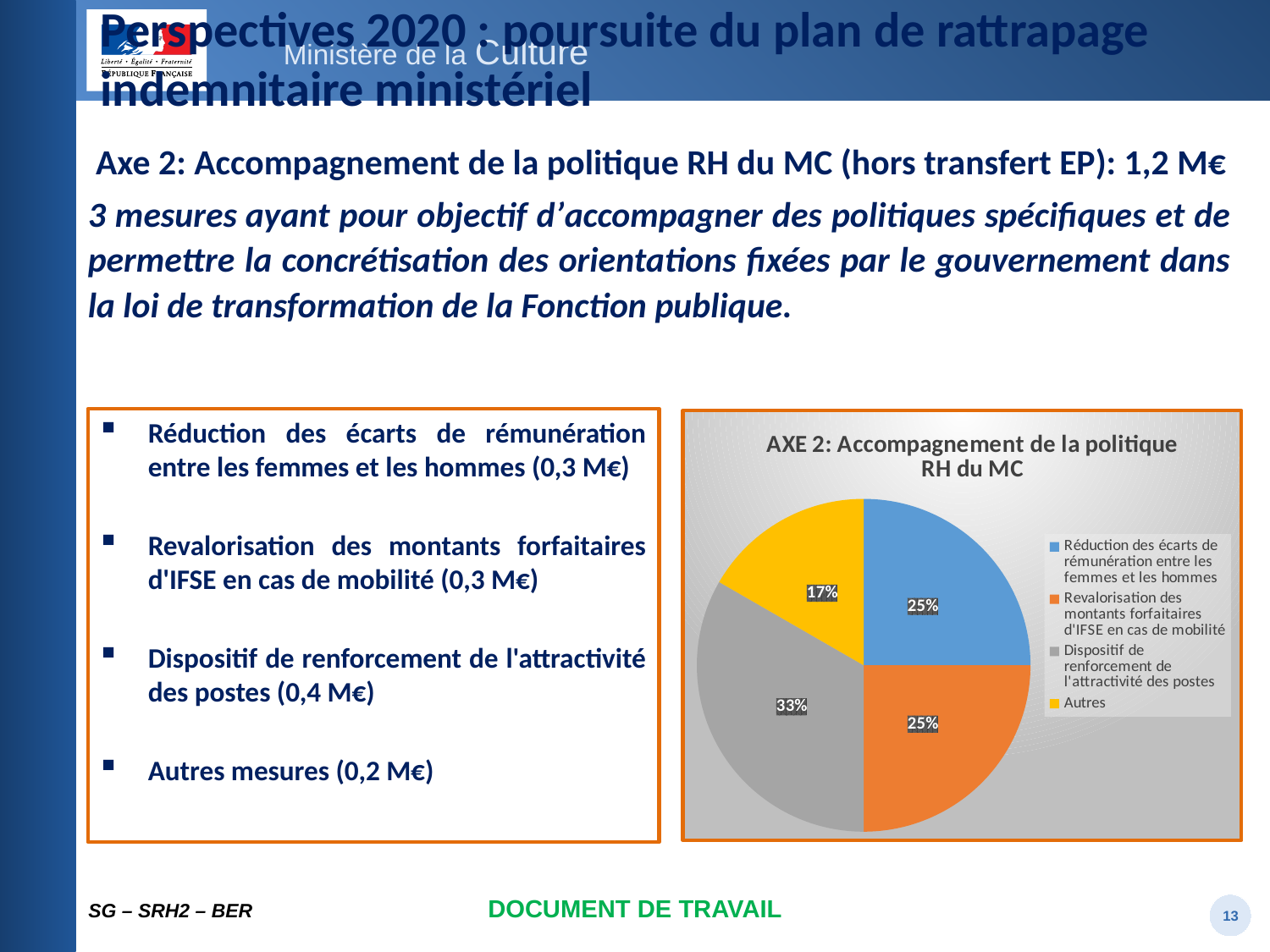
Which slice of the pie chart is the smallest? Autres Which slice of the pie chart is the largest? Dispositif de renforcement de l'attractivité des postes How many slices does the pie chart have? 4 What share of the pie is 'Réduction des écarts de rémunération entre les femmes et les hommes'? 25% What share of the pie is 'Dispositif de renforcement de l'attractivité des postes'? 33% How many entries does the chart legend list? 4 What is the difference in percentage points between the 'Dispositif de renforcement de l'attractivité des postes' slice and the 'Autres' slice? 16 What share of the pie is 'Revalorisation des montants forfaitaires d'IFSE en cas de mobilité'? 25% What kind of chart is shown on the slide? pie chart What is the title of the chart? AXE 2: Accompagnement de la politique RH du MC Which is larger: the 'Autres' slice or the 'Revalorisation des montants forfaitaires d'IFSE en cas de mobilité' slice? Revalorisation des montants forfaitaires d'IFSE en cas de mobilité